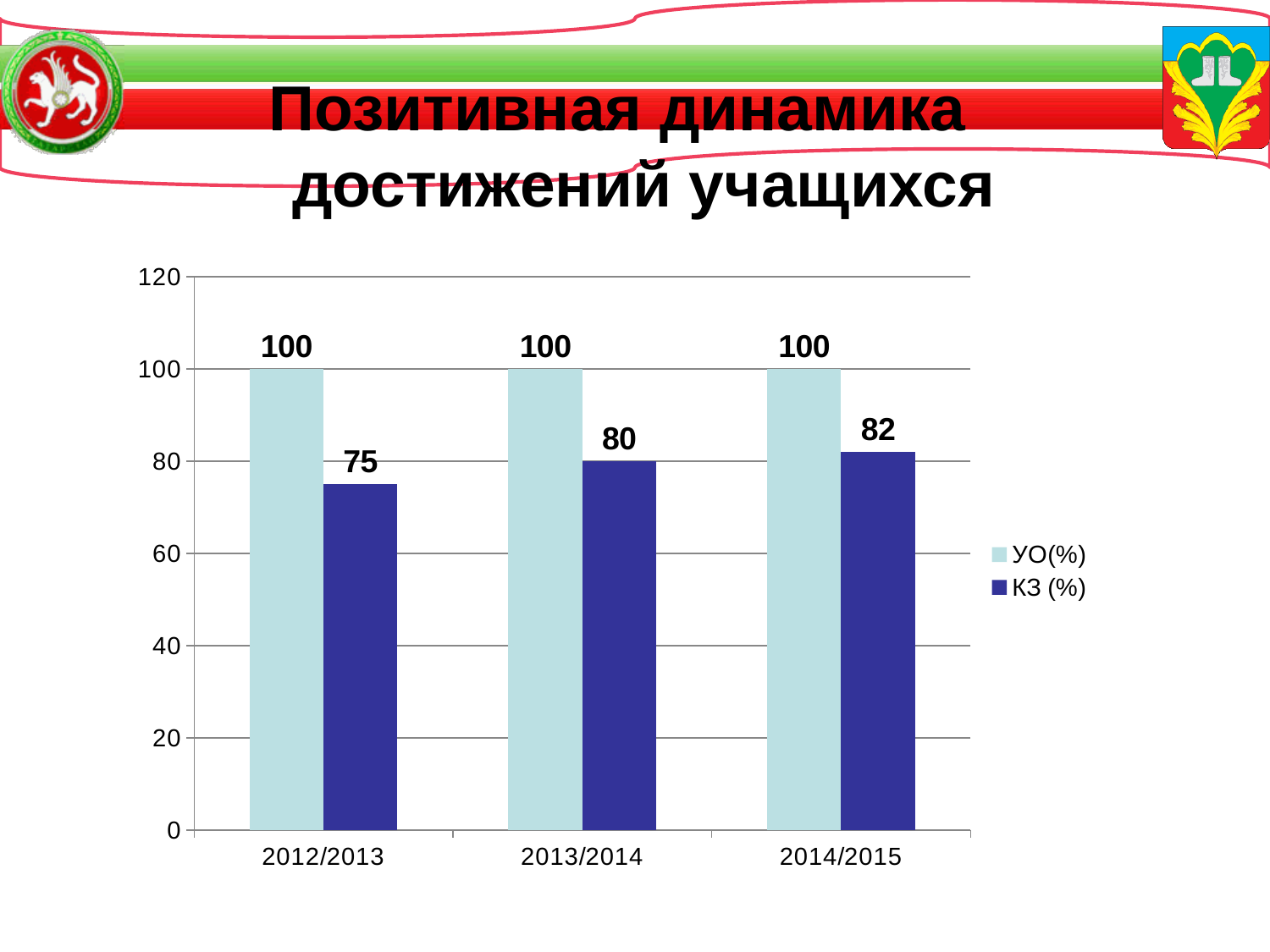
Which is larger in 2013/2014: УО(%) or КЗ (%)? УО(%) By how much did КЗ (%) increase from 2012/2013 to 2014/2015? 7 What is the value of КЗ (%) for 2014/2015? 82 Does КЗ (%) rise or fall from 2012/2013 to 2014/2015? Rise What kind of chart is shown on the slide? Bar chart What is the value of УО(%) for 2012/2013? 100 What is the value of КЗ (%) for 2013/2014? 80 How many school years are shown on the x axis? 3 What is the difference between УО(%) and КЗ (%) in 2012/2013? 25 In which school year is КЗ (%) lowest? 2012/2013 In which school year is КЗ (%) highest? 2014/2015 How many series does the legend list? 2